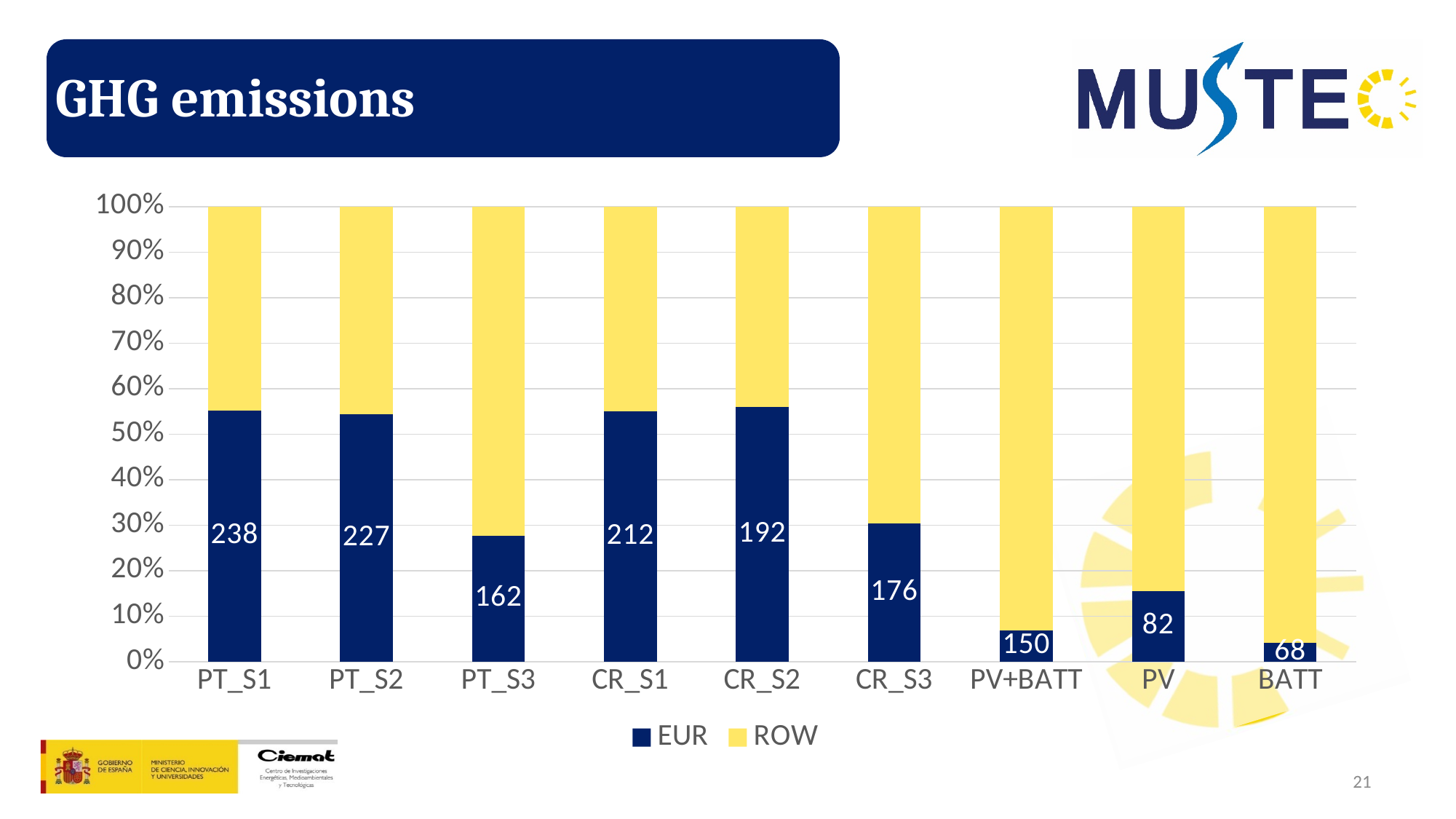
Is the EUR share for PV+BATT greater or less than 10%? less What is the difference between the EUR data labels for PT_S1 and PT_S2? 11 How many series does the legend list? 2 Which has the larger EUR data label, CR_S1 or CR_S3? CR_S1 What is the data label shown on the EUR segment for PT_S1? 238 What is the data label shown on the EUR segment for CR_S2? 192 What kind of chart is shown on the slide? Stacked bar chart What is the data label shown on the EUR segment for PV? 82 Which category has the highest EUR data label? PT_S1 How many categories are shown on the x axis? 9 Which category has the lowest EUR data label? BATT Is the EUR share for PT_S1 greater or less than 50%? greater